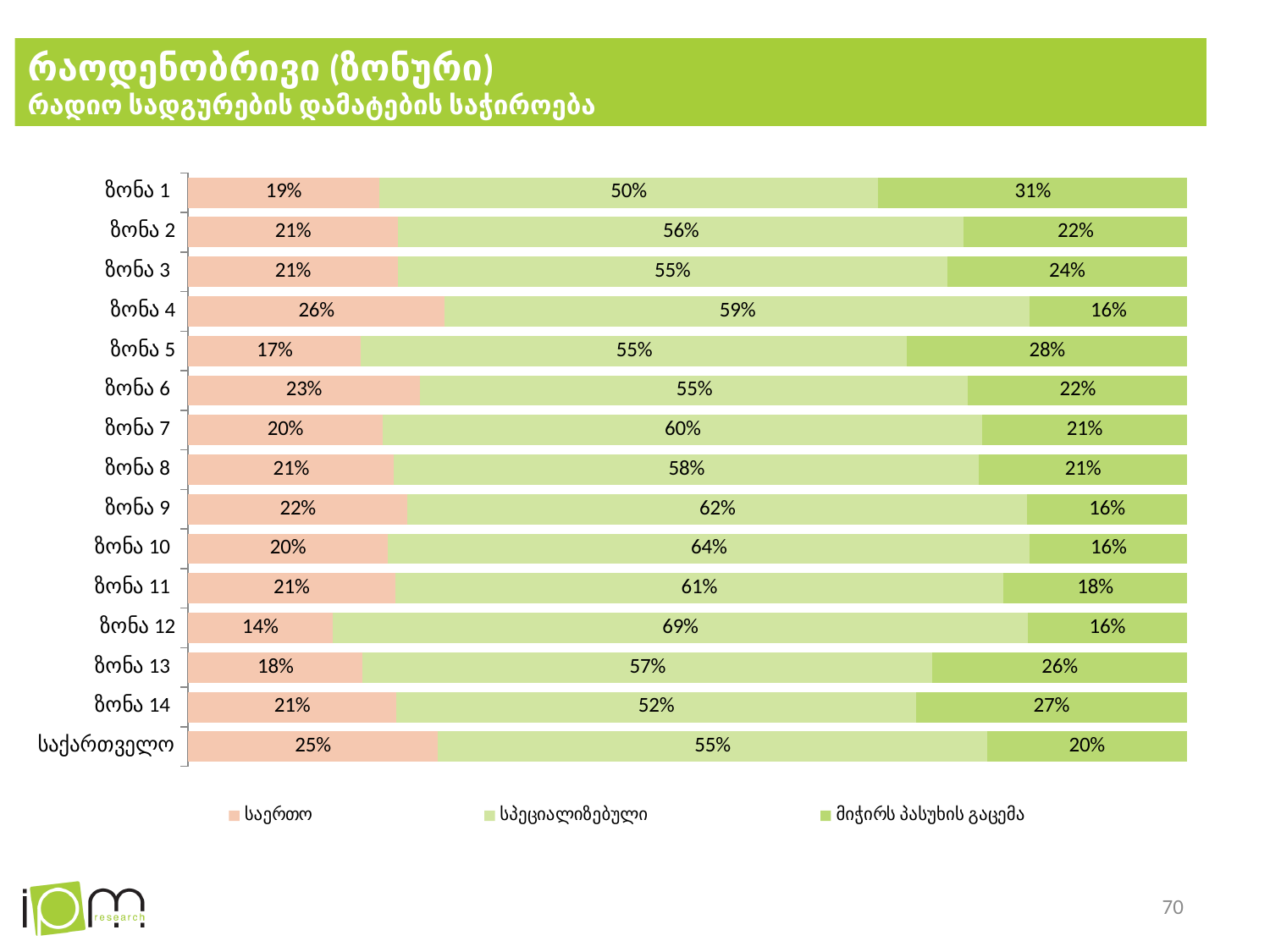
Which category has the highest value for სპეციალიზებული? ზონა 12 How many series does the legend list? 3 What type of chart is shown on the slide? stacked bar chart Which category has the highest value for საერთო? ზონა 4 Which category has the lowest value for საერთო? ზონა 12 Which is larger: the მიჭირს პასუხის გაცემა value for ზონა 5 or for ზონა 13? ზონა 5 How many categories (bars) are shown in the chart? 15 What is the difference between the სპეციალიზებული values for ზონა 10 and ზონა 1? 14% What is the value of საერთო for საქართველო? 25% What is the value of მიჭირს პასუხის გაცემა for ზონა 1? 31% What is the subtitle of the chart shown below the main title? რადიო სადგურების დამატების საჭიროება What is the value of სპეციალიზებული for ზონა 12? 69%